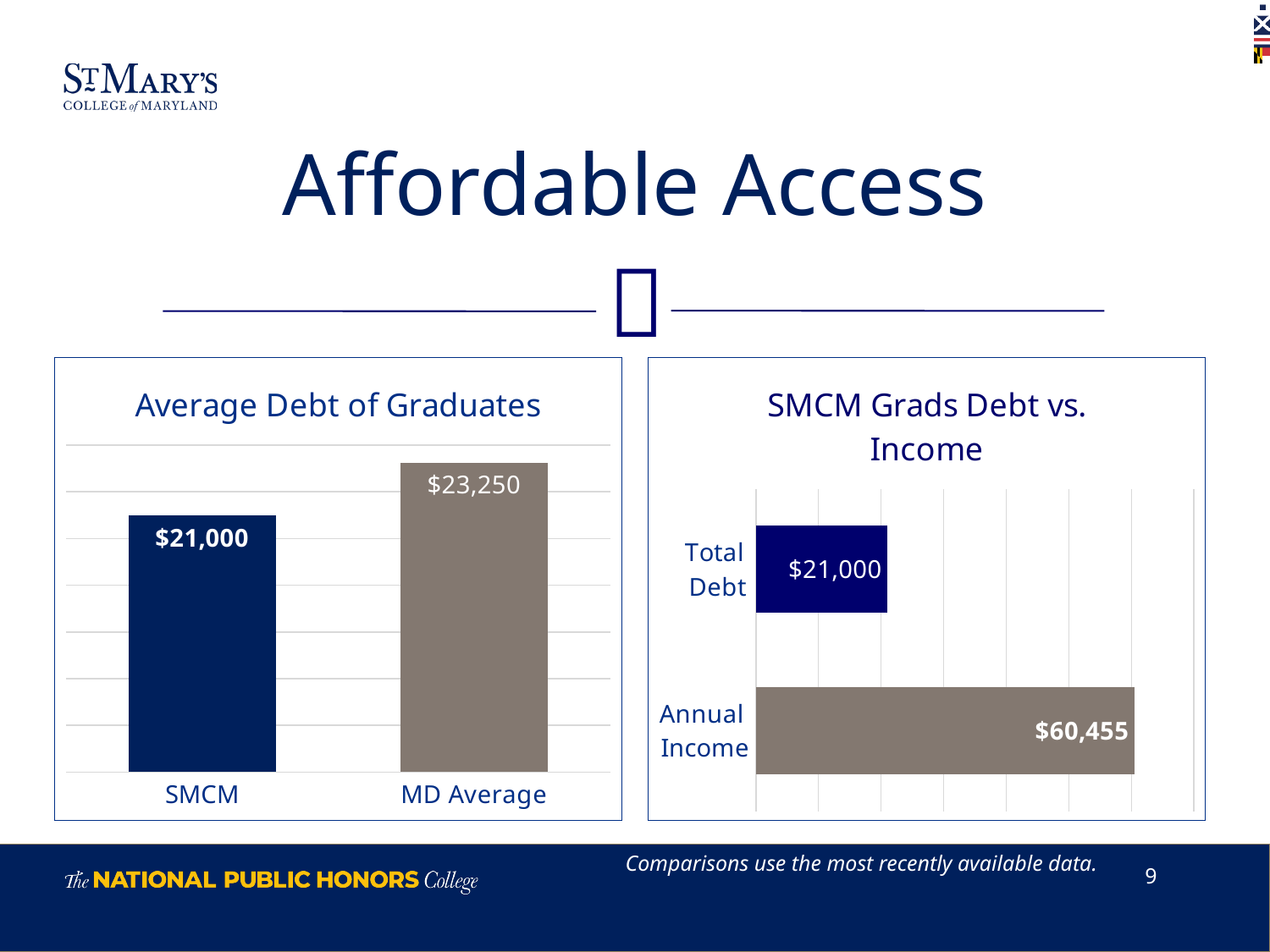
In the 'SMCM Grads Debt vs. Income' chart, what is the value for Total Debt? $21,000 In the 'SMCM Grads Debt vs. Income' chart, what is the difference between Annual Income and Total Debt? $39,455 In the 'SMCM Grads Debt vs. Income' chart, which category has the lower value? Total Debt In the 'Average Debt of Graduates' chart, which category has the higher value? MD Average In the 'Average Debt of Graduates' chart, what is the difference between the MD Average and SMCM values? $2,250 What kind of chart is the 'SMCM Grads Debt vs. Income' chart? Bar chart What kind of chart is the 'Average Debt of Graduates' chart? Bar chart In the 'SMCM Grads Debt vs. Income' chart, what is the value for Annual Income? $60,455 In the 'Average Debt of Graduates' chart, how many categories are shown? 2 What is the title of the chart on the right side of the slide? SMCM Grads Debt vs. Income In the 'Average Debt of Graduates' chart, what is the value for MD Average? $23,250 In the 'Average Debt of Graduates' chart, what is the value for SMCM? $21,000